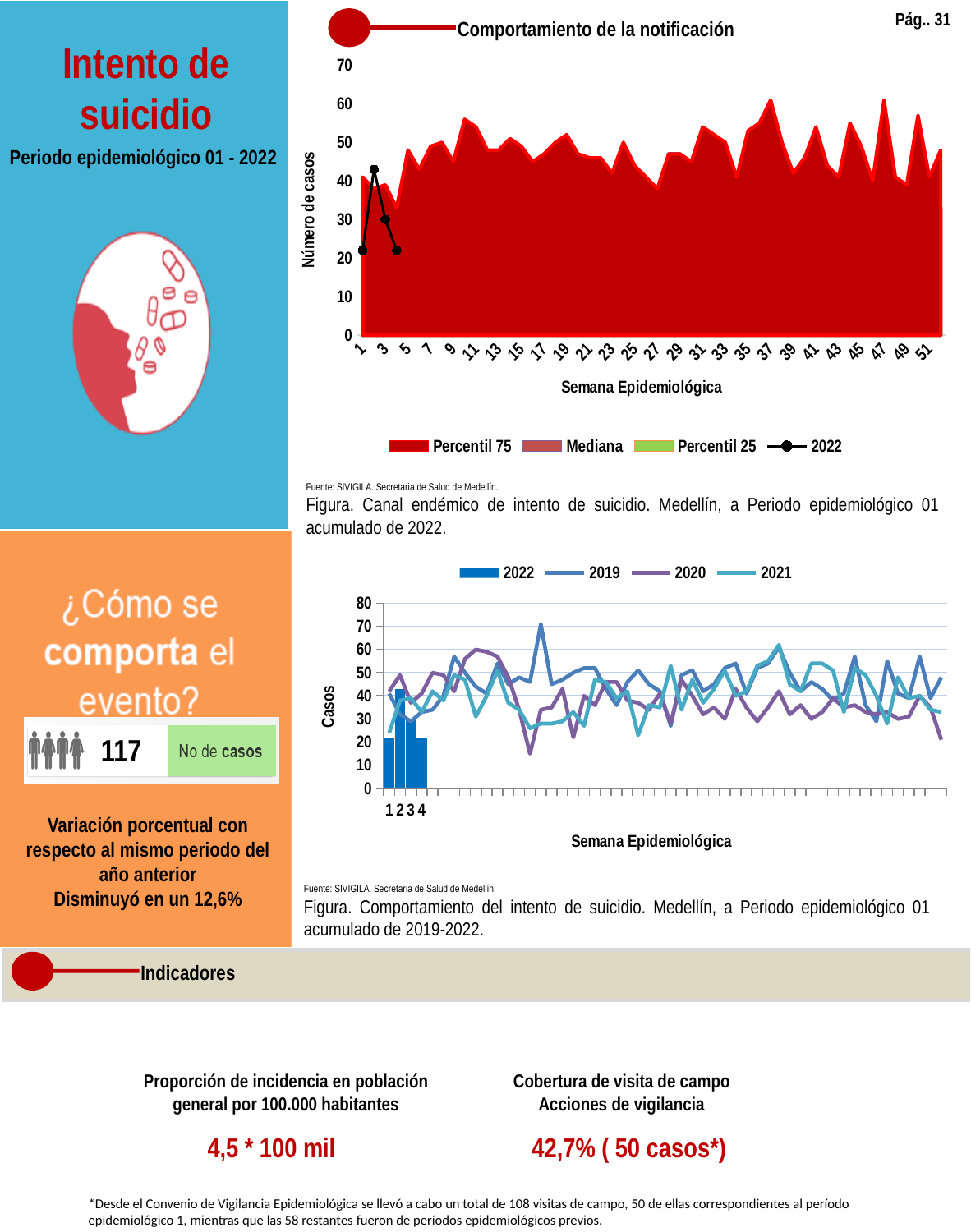
In the top chart titled 'Comportamiento de la notificación', what is the label of the x axis? Semana Epidemiológica In the top chart titled 'Comportamiento de la notificación', what are the legend entries? Percentil 75, Mediana, Percentil 25, 2022 In the top chart titled 'Comportamiento de la notificación', is the 2022 value at week 1 greater or less than 30? less In the bottom chart (Comportamiento del intento de suicidio 2019-2022), how many bars are plotted for 2022? 4 In the top chart titled 'Comportamiento de la notificación', how many series does the legend list? 4 In the top chart titled 'Comportamiento de la notificación', at which epidemiological week is the 2022 value highest? 2 In the bottom chart (Comportamiento del intento de suicidio 2019-2022), is the 2022 bar for week 3 greater or less than 20? greater In the bottom chart (Comportamiento del intento de suicidio 2019-2022), how many series does the legend list? 4 In the top chart titled 'Comportamiento de la notificación', is the 2022 value at week 2 greater or less than 40? greater In the bottom chart (Comportamiento del intento de suicidio 2019-2022), which week has the tallest 2022 bar? 2 In the bottom chart (Comportamiento del intento de suicidio 2019-2022), is the 2022 bar for week 2 larger or smaller than the 2022 bar for week 4? larger In the top chart titled 'Comportamiento de la notificación', how many data points does the 2022 line have? 4